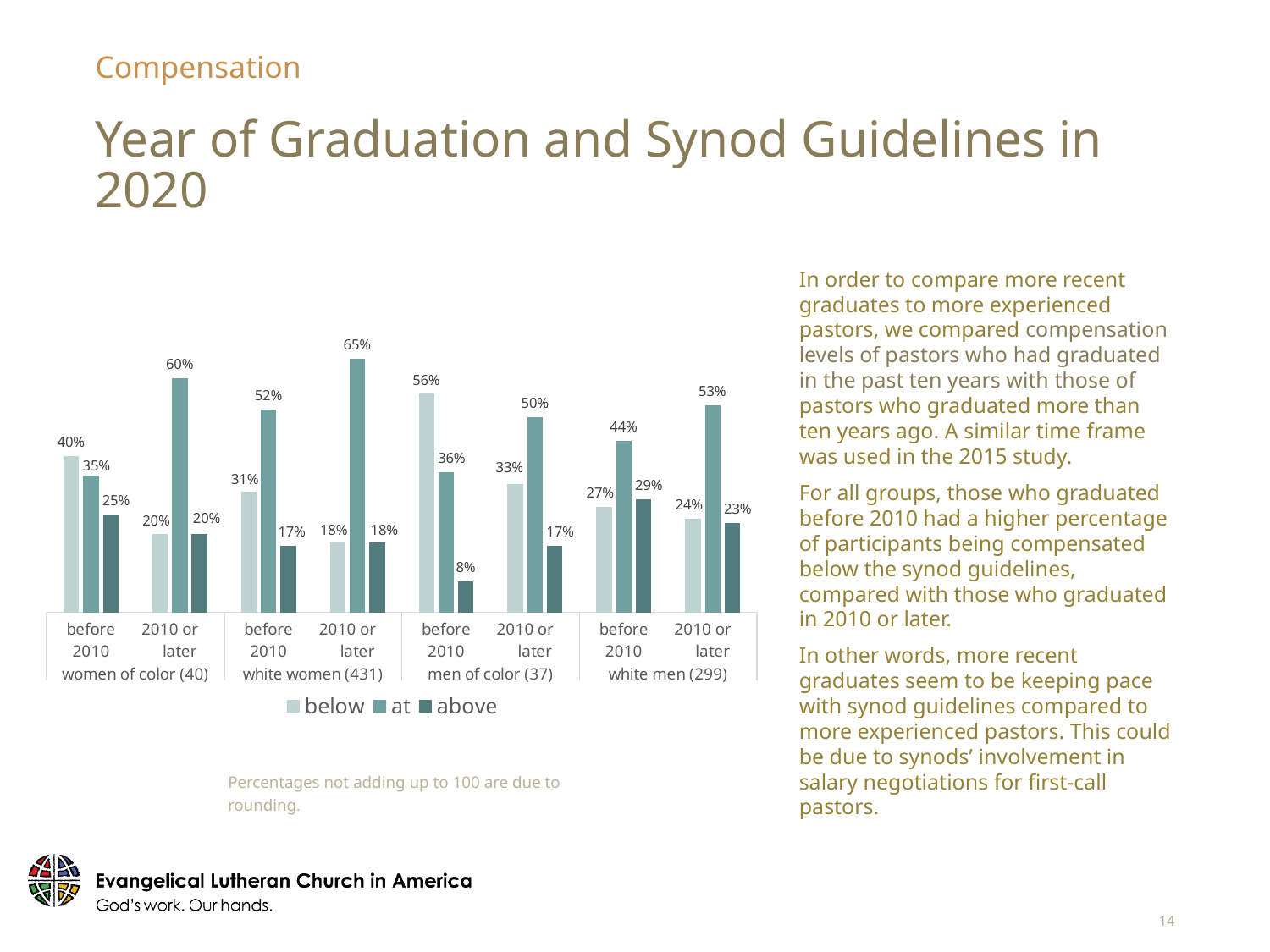
What are the three legend entries of the chart? below, at, above Which is larger for women of color who graduated before 2010: the 'below' value or the 'at' value? below What is the 'at' value for white women who graduated in 2010 or later? 65% What kind of chart is shown on the slide? bar chart What is the 'above' value for men of color who graduated before 2010? 8% What is the 'below' value for white women who graduated before 2010? 31% What is the difference between the 'at' values for white men who graduated in 2010 or later and those who graduated before 2010? 9% What is the 'below' value for white men who graduated in 2010 or later? 24% What is the difference between the 'below' values for men of color who graduated before 2010 and those who graduated in 2010 or later? 23% How many series does the legend list? 3 Which group and graduation period has the lowest 'above' value? men of color, before 2010 Which group and graduation period has the highest 'at' value? white women, 2010 or later